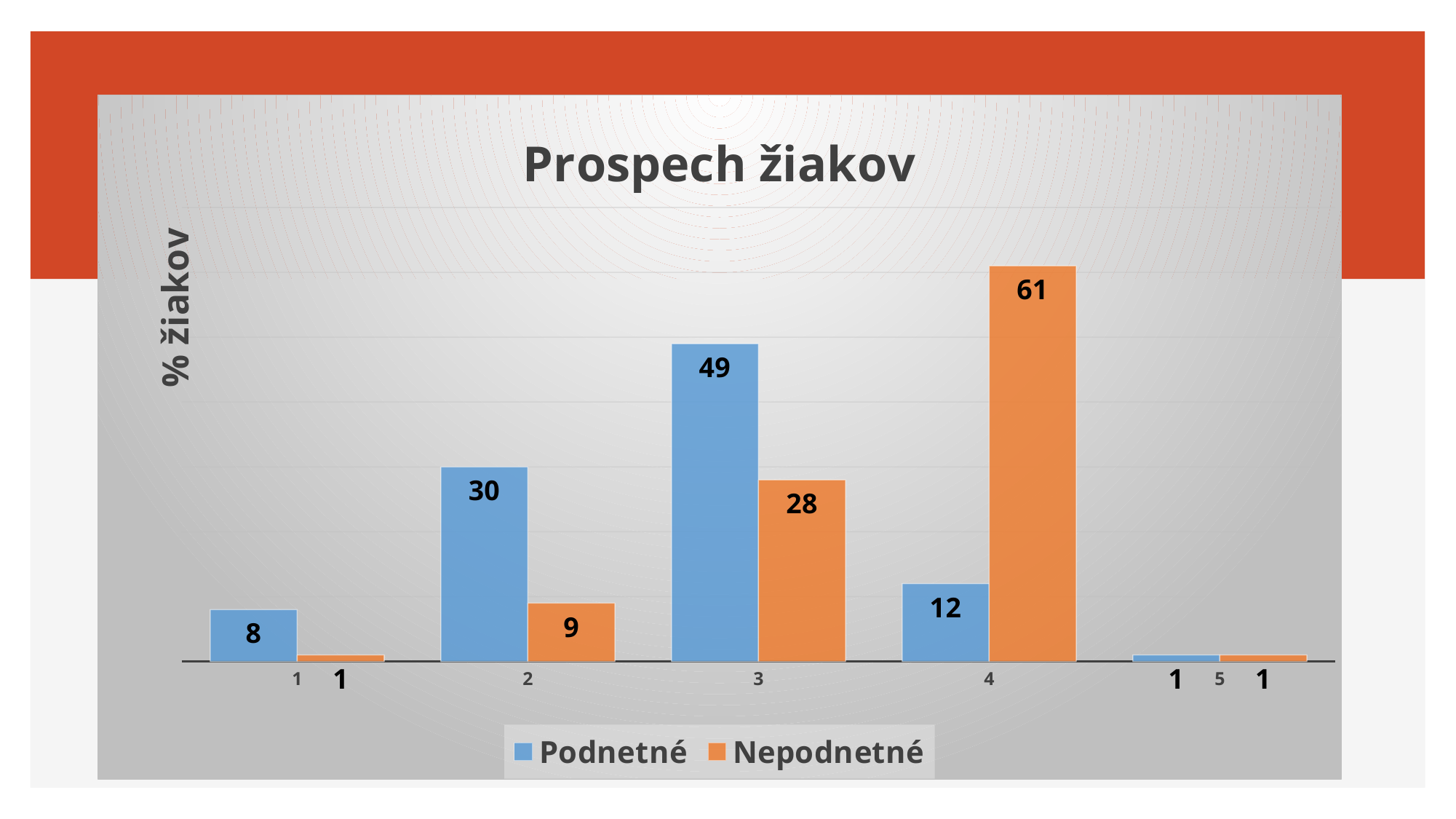
In which category is the Nepodnetné series highest? 4 What is the value for Nepodnetné in category 2? 9 What is the title of the chart? Prospech žiakov What is the value for Podnetné in category 3? 49 In which category is the Podnetné series highest? 3 What is the value for Nepodnetné in category 4? 61 What is the difference between Podnetné and Nepodnetné in category 3? 21 What is the difference between Nepodnetné and Podnetné in category 4? 49 How many categories are shown on the x axis? 5 Which is larger in category 2, Podnetné or Nepodnetné? Podnetné How many series does the legend list? 2 What is the value for Podnetné in category 1? 8